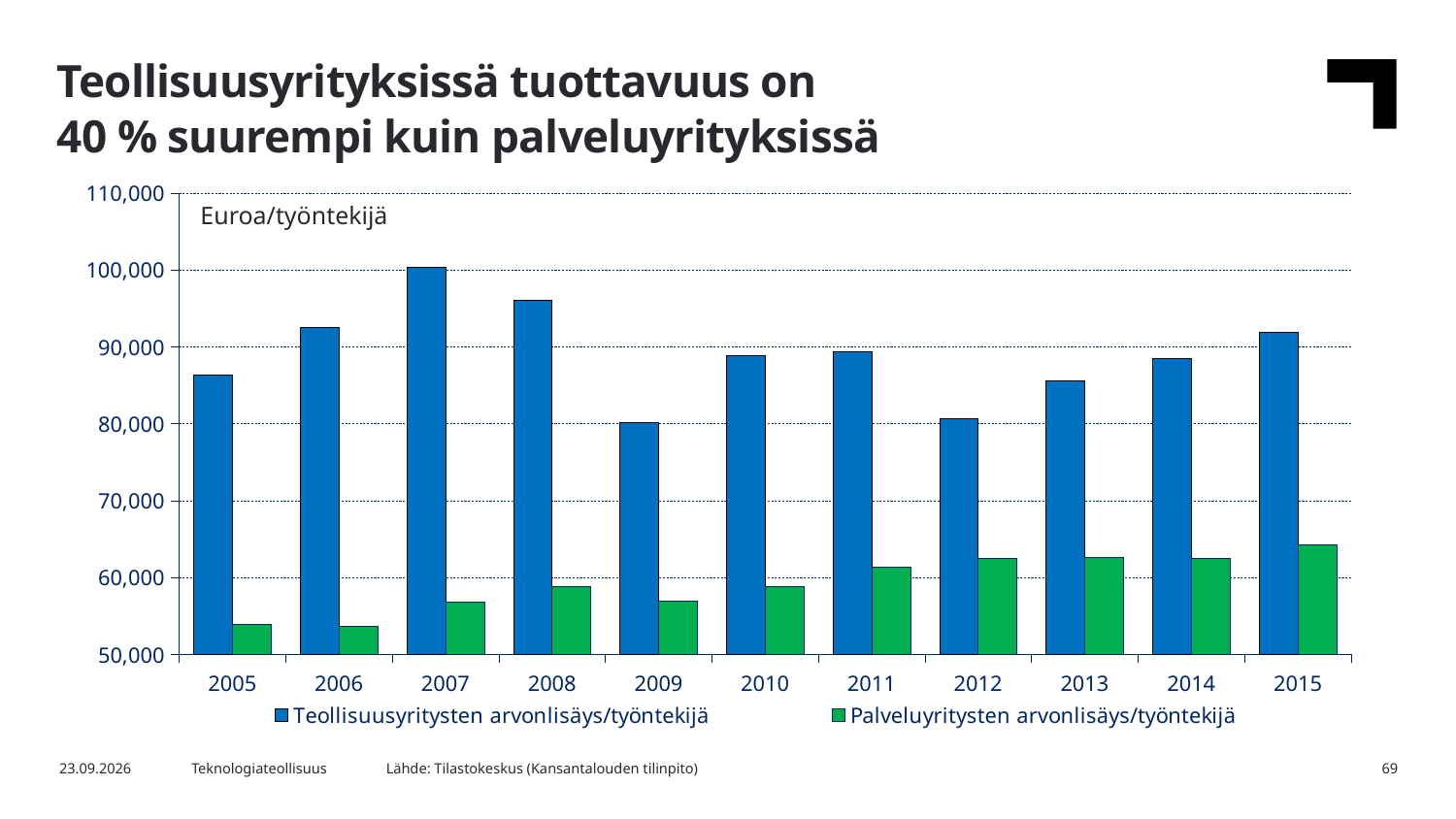
In which year is the value for Teollisuusyritysten arvonlisäys/työntekijä highest? 2007 What unit label is shown inside the chart area at the top left? Euroa/työntekijä Does the value for Palveluyritysten arvonlisäys/työntekijä generally rise or fall from 2005 to 2015? Rise Is the value for Teollisuusyritysten arvonlisäys/työntekijä in 2009 greater or less than 90,000? less Is the value for Palveluyritysten arvonlisäys/työntekijä in 2005 greater or less than 60,000? less How many years are shown on the x axis? 11 How many series does the legend list? 2 Which year has the larger value for Teollisuusyritysten arvonlisäys/työntekijä, 2005 or 2006? 2006 Is the value for Palveluyritysten arvonlisäys/työntekijä in 2015 greater or less than 60,000? greater What kind of chart is shown on the slide? Bar chart In which year is the value for Palveluyritysten arvonlisäys/työntekijä highest? 2015